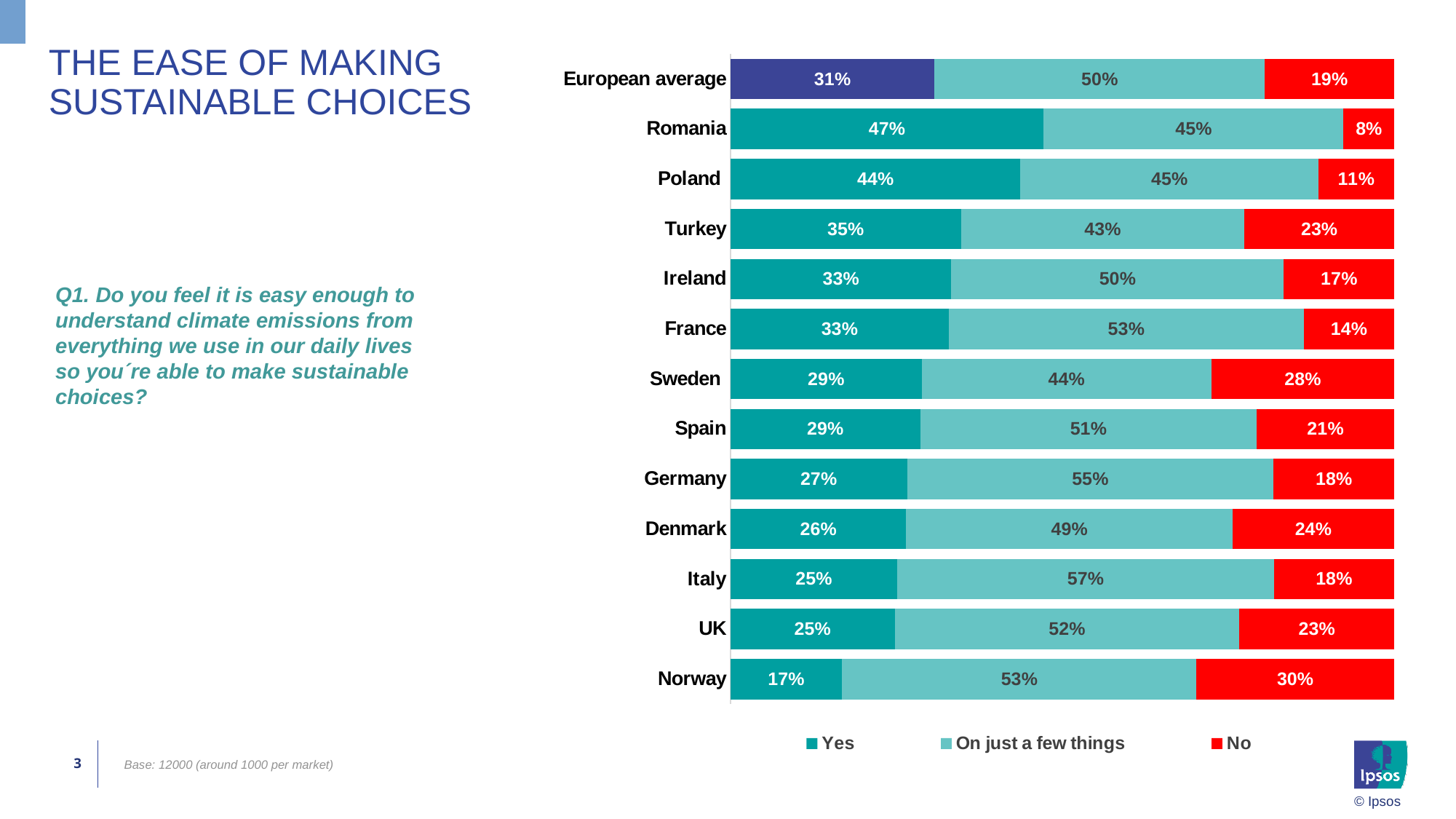
What is the "On just a few things" value for Italy? 57% Which country has the highest "Yes" percentage? Romania What is the "No" value for Norway? 30% Which country has the lowest "No" percentage? Romania What percentage of respondents in Romania answered "Yes"? 47% What is the European average for "Yes"? 31% What is the difference between the "Yes" percentages for Poland and Germany? 17% Which country has the lowest "Yes" percentage? Norway How many series does the legend list? 3 How many categories (rows) are shown in the chart, including the European average? 13 What type of chart is shown on the slide? Stacked bar chart Which has a higher "No" percentage, Sweden or Spain? Sweden